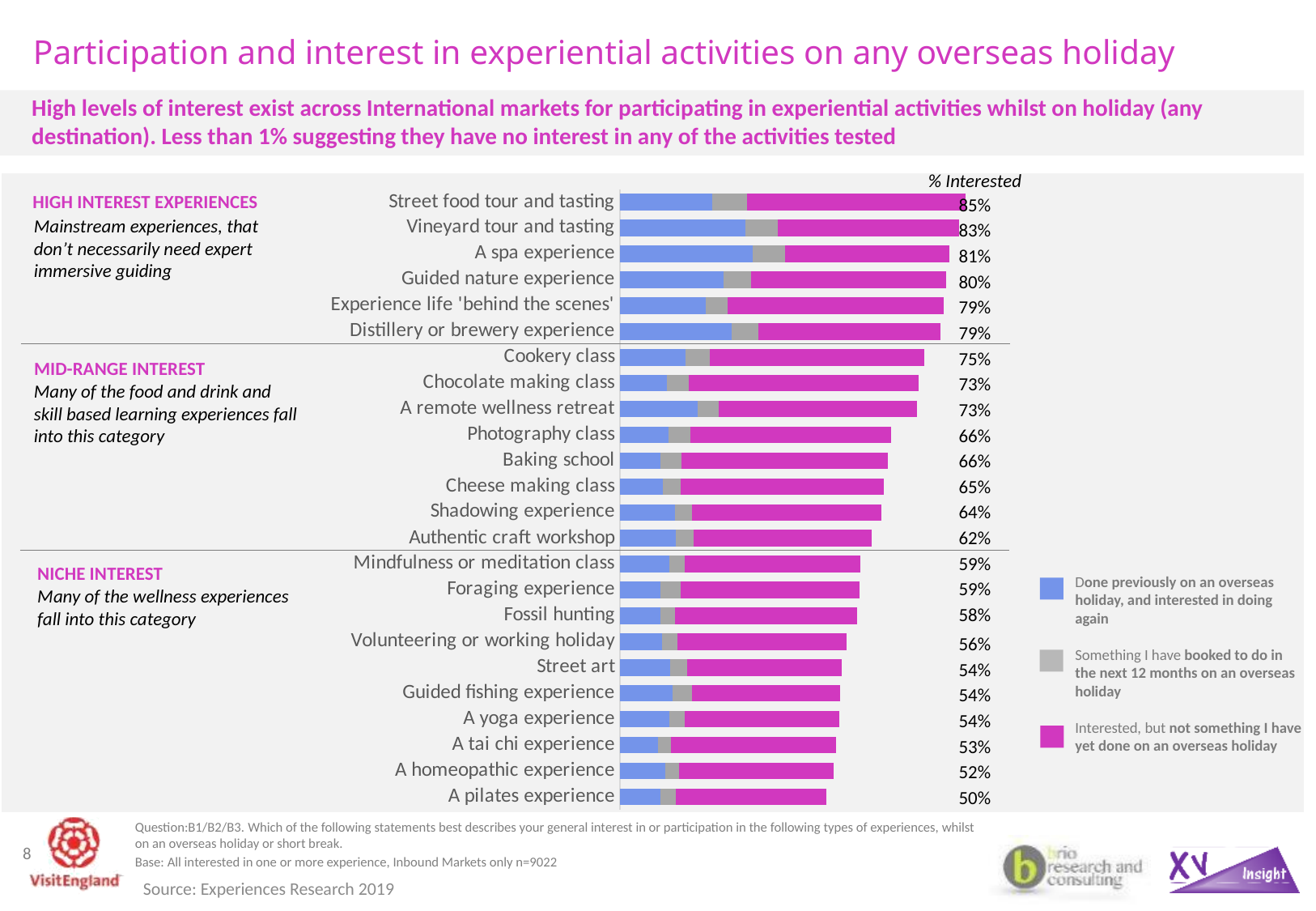
What kind of chart is shown on the slide? Stacked bar chart What is the % Interested value for A pilates experience? 50% What is the % Interested value for Cookery class? 75% What is the difference in % Interested between Street food tour and tasting and A pilates experience? 35% Which has a higher % Interested value, A spa experience or Fossil hunting? A spa experience What is the % Interested value for Street food tour and tasting? 85% Which activity has the highest % Interested value? Street food tour and tasting What is the difference in % Interested between Vineyard tour and tasting and Photography class? 17% Which activity has the lowest % Interested value? A pilates experience Which colour represents 'Interested, but not something I have yet done on an overseas holiday'? Magenta (pink) How many activities are shown in the chart? 24 How many series does the legend list? 3